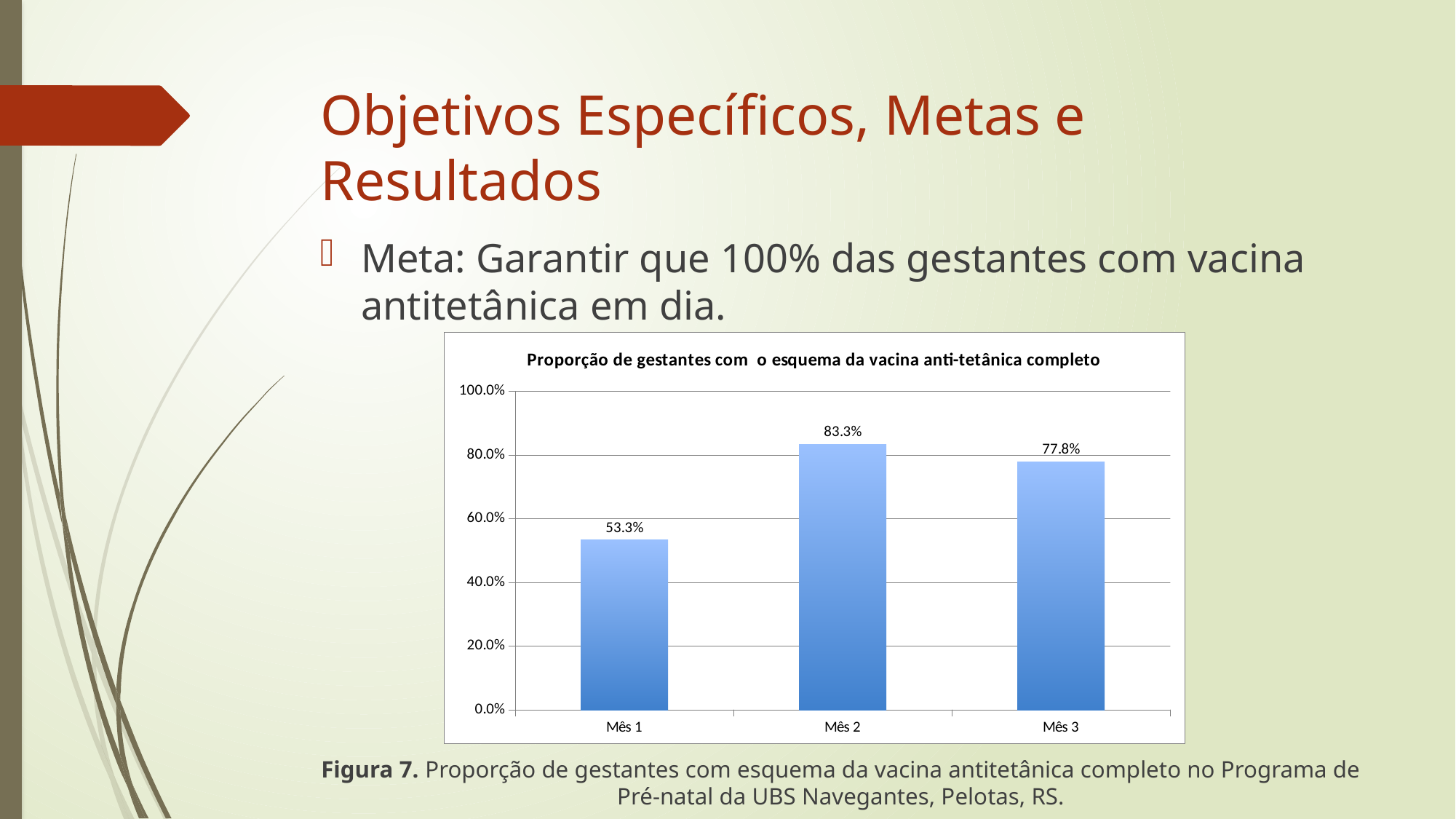
What kind of chart is shown? bar chart What is the value for Mês 2? 83.3% Which month has the highest proportion? Mês 2 Is the value for Mês 1 greater or less than 60.0%? less What is the value for Mês 3? 77.8% What is the difference between the values for Mês 2 and Mês 1? 30.0% Which month has the lowest proportion? Mês 1 What is the difference between the values for Mês 2 and Mês 3? 5.5% Which is larger, the value for Mês 3 or the value for Mês 1? Mês 3 What is the title of the chart? Proporção de gestantes com o esquema da vacina anti-tetânica completo What is the value for Mês 1? 53.3% How many months are shown on the x axis? 3